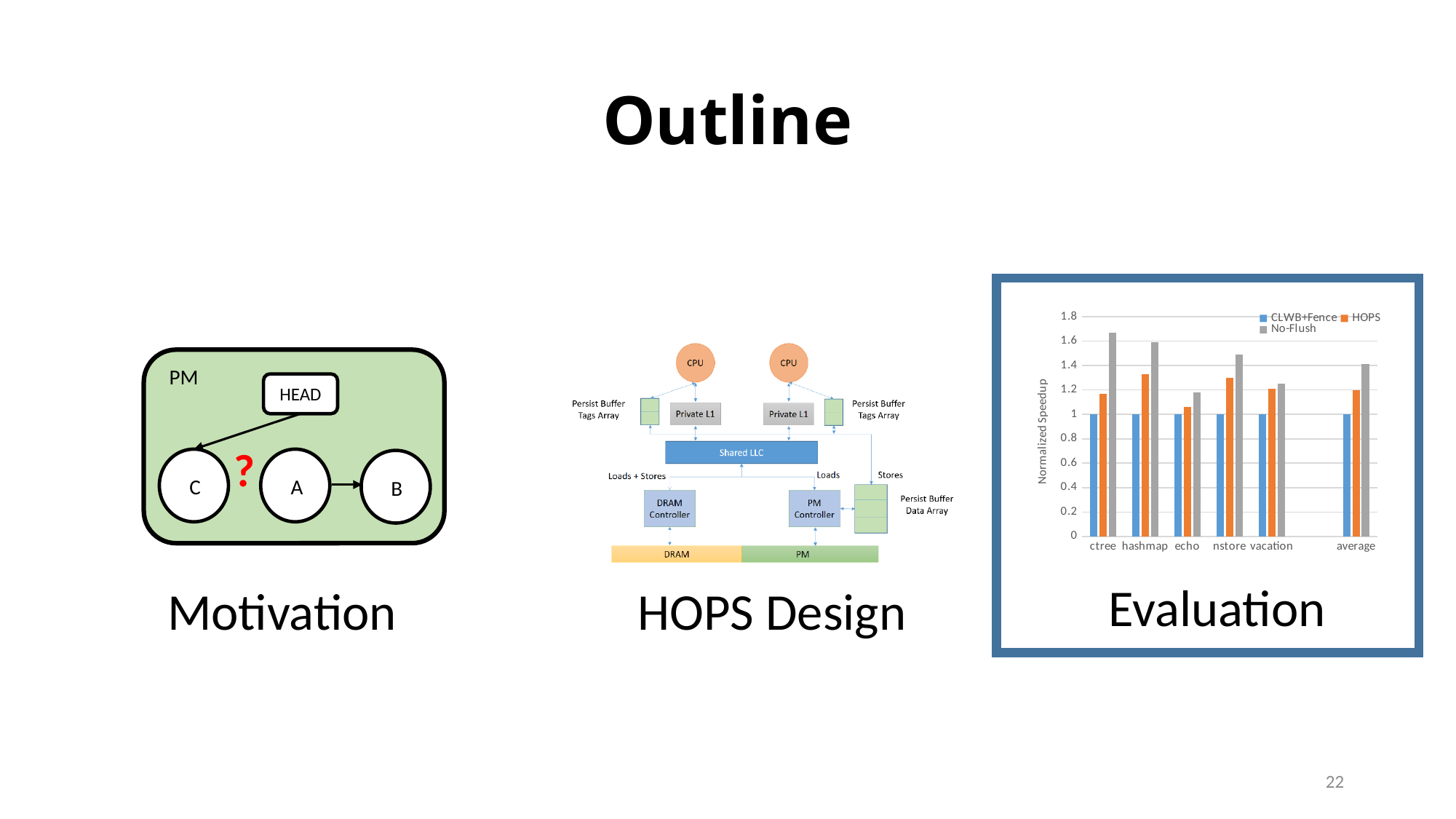
How many categories are shown on the x axis of the Evaluation chart? 6 In the Evaluation chart, is the No-Flush value for ctree greater or less than 1.6? greater In the Evaluation chart, which category has the highest HOPS value? hashmap In the Evaluation chart, is the No-Flush value for nstore greater or less than 1.4? greater What kind of chart is shown in the Evaluation panel? bar chart In the Evaluation chart, which category has the highest No-Flush value? ctree In the Evaluation chart, which is larger: the No-Flush value for ctree or the No-Flush value for echo? ctree How many series does the legend of the Evaluation chart list? 3 What is the y-axis label of the Evaluation chart? Normalized Speedup In the Evaluation chart, which category has the lowest HOPS value? echo In the Evaluation chart, what is the CLWB+Fence value for ctree? 1 In the Evaluation chart, is the HOPS value for echo greater or less than 1.2? less